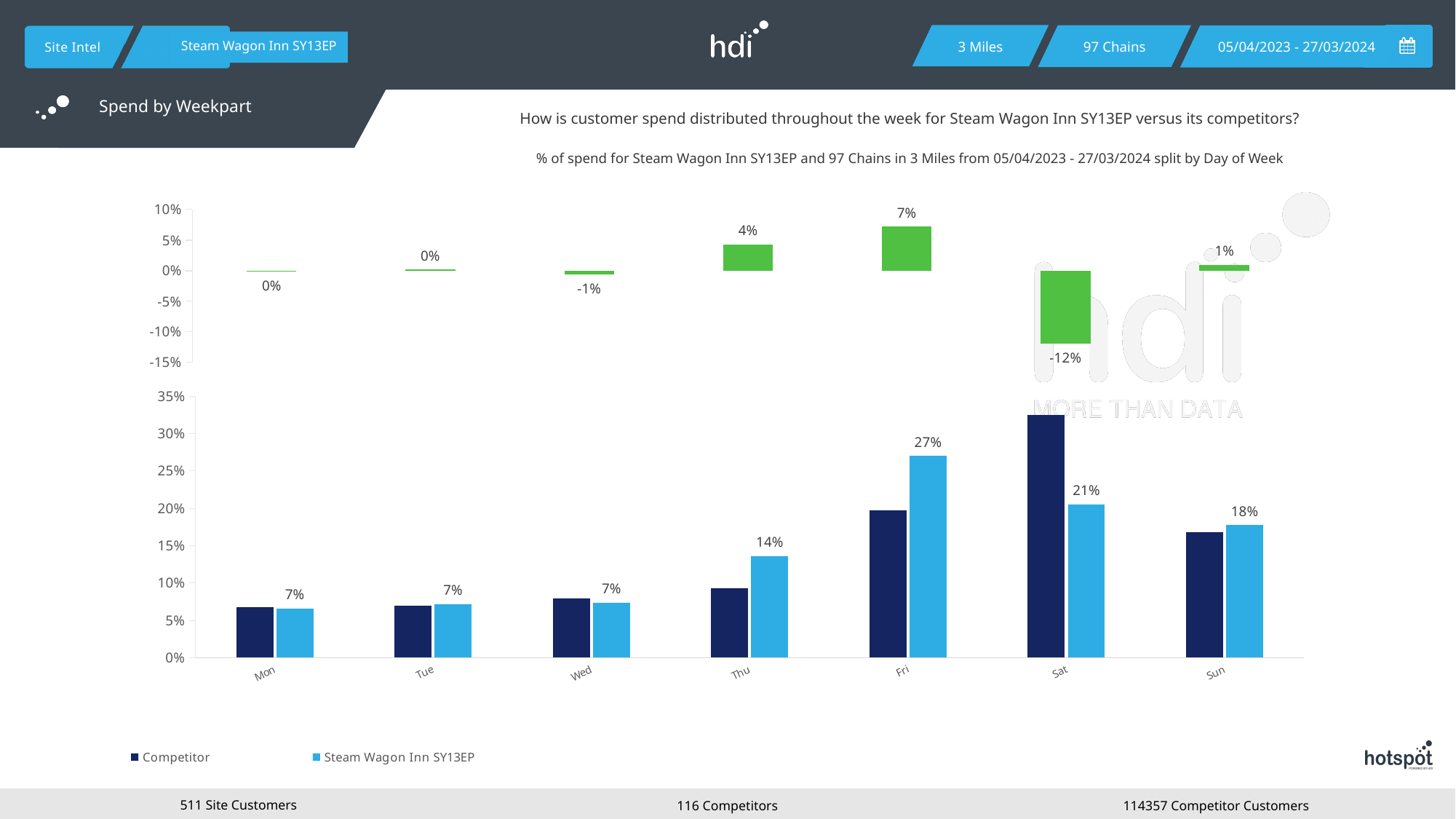
In the bottom bar chart, what is the value for Steam Wagon Inn SY13EP on Fri? 27% In the bottom bar chart, how many series does the legend list? 2 What kind of chart is the bottom chart? bar chart In the bottom bar chart, what is the difference between the Steam Wagon Inn SY13EP values for Fri and Sat? 6% In the top chart, what is the value shown for Sat? -12% In the bottom bar chart, is the Competitor value for Sat greater or less than 30%? greater In the bottom bar chart, what is the value for Steam Wagon Inn SY13EP on Thu? 14% In the top chart, which day has the highest value? Fri In the bottom bar chart, which is larger on Sat: the Competitor value or the Steam Wagon Inn SY13EP value? Competitor In the bottom bar chart, which day has the highest value for Steam Wagon Inn SY13EP? Fri How many days of the week are shown on the x axis of the bottom chart? 7